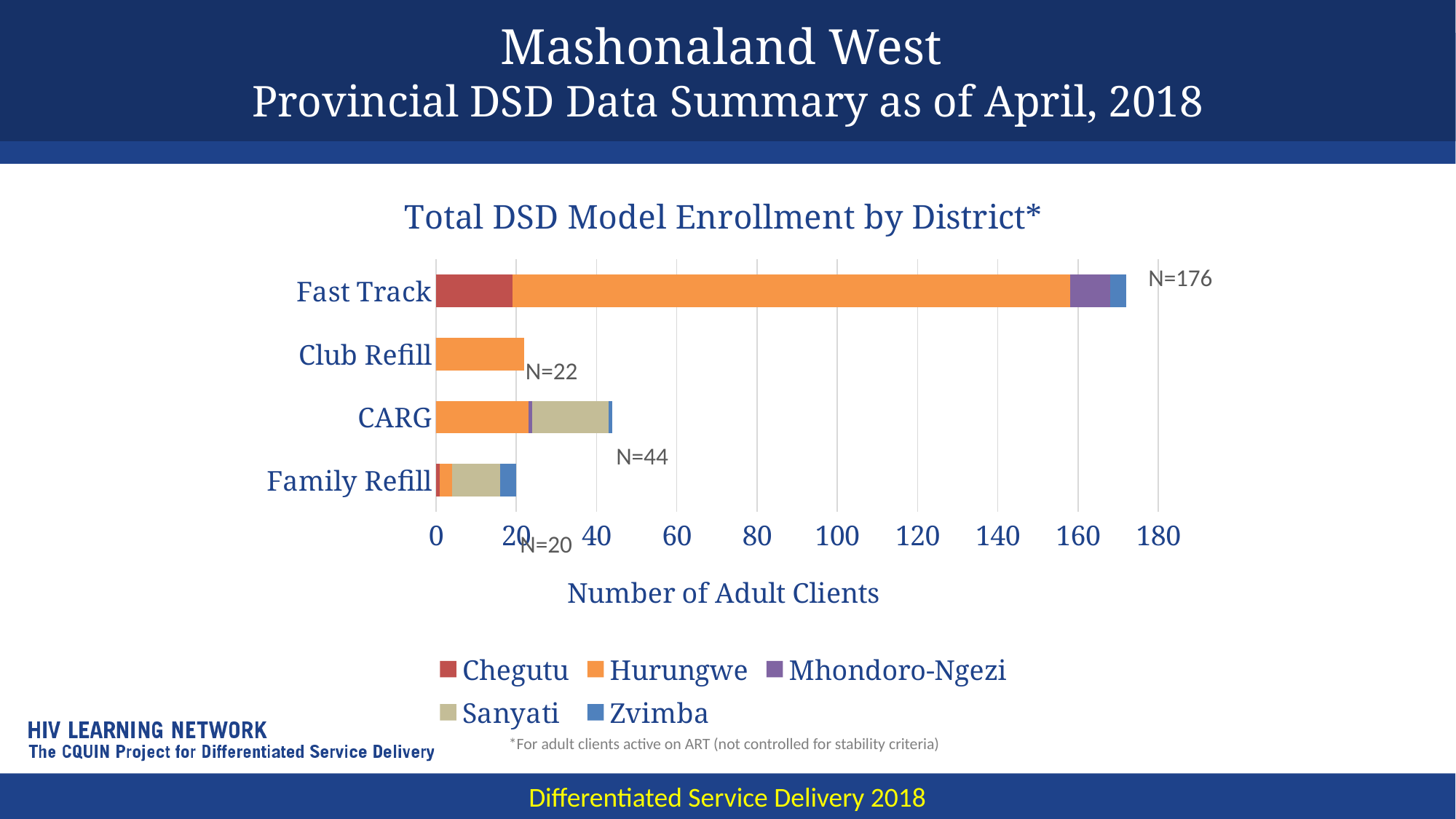
Which has a larger total enrollment, CARG or Club Refill? CARG Which DSD model has the lowest total enrollment? Family Refill What is the total enrollment (N) for CARG? N=44 How many DSD models are shown on the chart? 4 What is the total enrollment (N) for Club Refill? N=22 What is the difference in total enrollment between Fast Track and Club Refill? 154 Is the total value for Fast Track greater or less than 100? greater How many districts are listed in the legend? 5 Which DSD model has the highest total enrollment? Fast Track What is the difference in total enrollment between CARG and Family Refill? 24 What is the total enrollment (N) for Family Refill? N=20 What is the total enrollment (N) for Fast Track? N=176